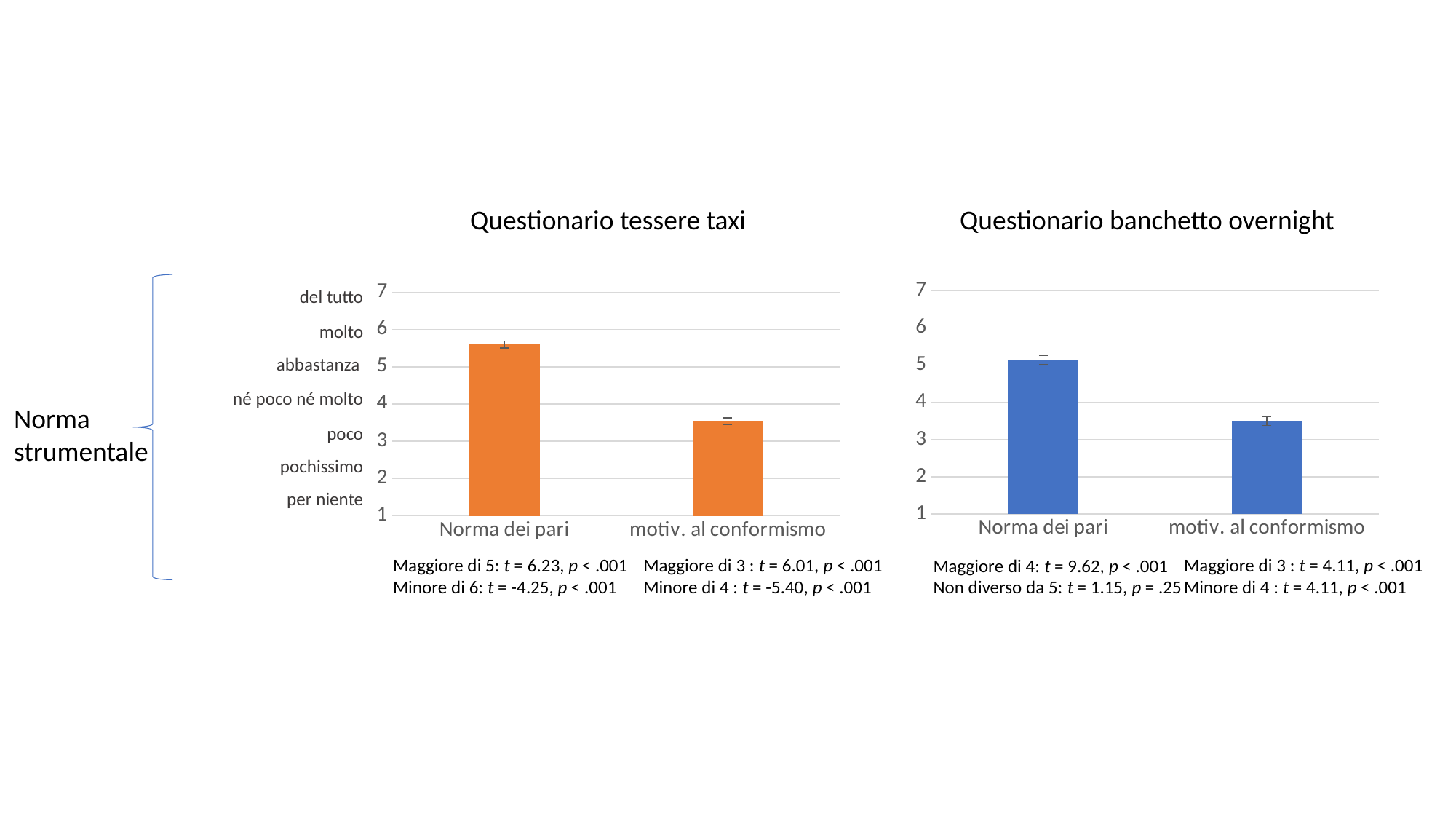
What kind of chart is the chart titled "Questionario banchetto overnight"? bar chart In the chart titled "Questionario tessere taxi", what is the highest value shown on the y axis? 7 In the chart titled "Questionario tessere taxi", is the value for Norma dei pari greater or less than 5? greater In the chart titled "Questionario banchetto overnight", is the value for motiv. al conformismo greater or less than 3? greater What colour are the bars in the chart titled "Questionario banchetto overnight"? blue In the chart titled "Questionario banchetto overnight", is the bar for Norma dei pari larger or smaller than the bar for motiv. al conformismo? larger What is the title of the chart on the left side of the slide? Questionario tessere taxi In the chart titled "Questionario tessere taxi", which category has the higher bar? Norma dei pari How many categories are shown on the x axis of the chart titled "Questionario tessere taxi"? 2 In the chart titled "Questionario banchetto overnight", is the value for Norma dei pari greater or less than 4? greater In the chart titled "Questionario banchetto overnight", which category has the lower bar? motiv. al conformismo